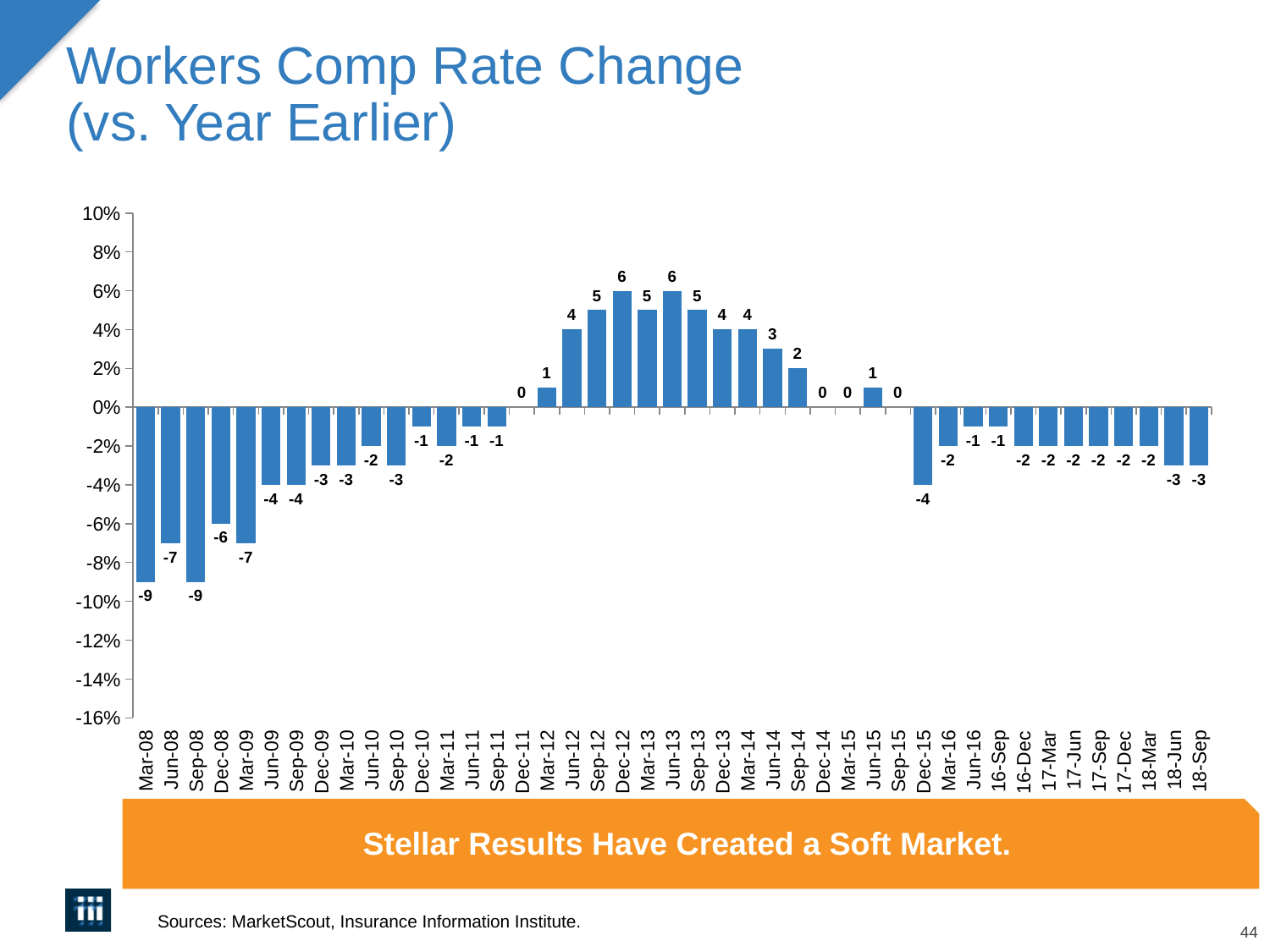
What is the value for Mar-08? -9 What is the value for 18-Sep? -3 What is the value for Dec-12? 6 What is the value for Jun-14? 3 What is the difference between the values for Dec-12 and Dec-15? 10 Do the values rise or fall from Mar-08 to Dec-12? Rise What is the title of the chart? Workers Comp Rate Change (vs. Year Earlier) Which is larger, the value for Dec-08 or the value for Mar-09? Dec-08 What is the highest value shown on the chart? 6 What is the value for Dec-15? -4 How many periods are plotted on the x axis? 43 What kind of chart is shown on the slide? Bar chart